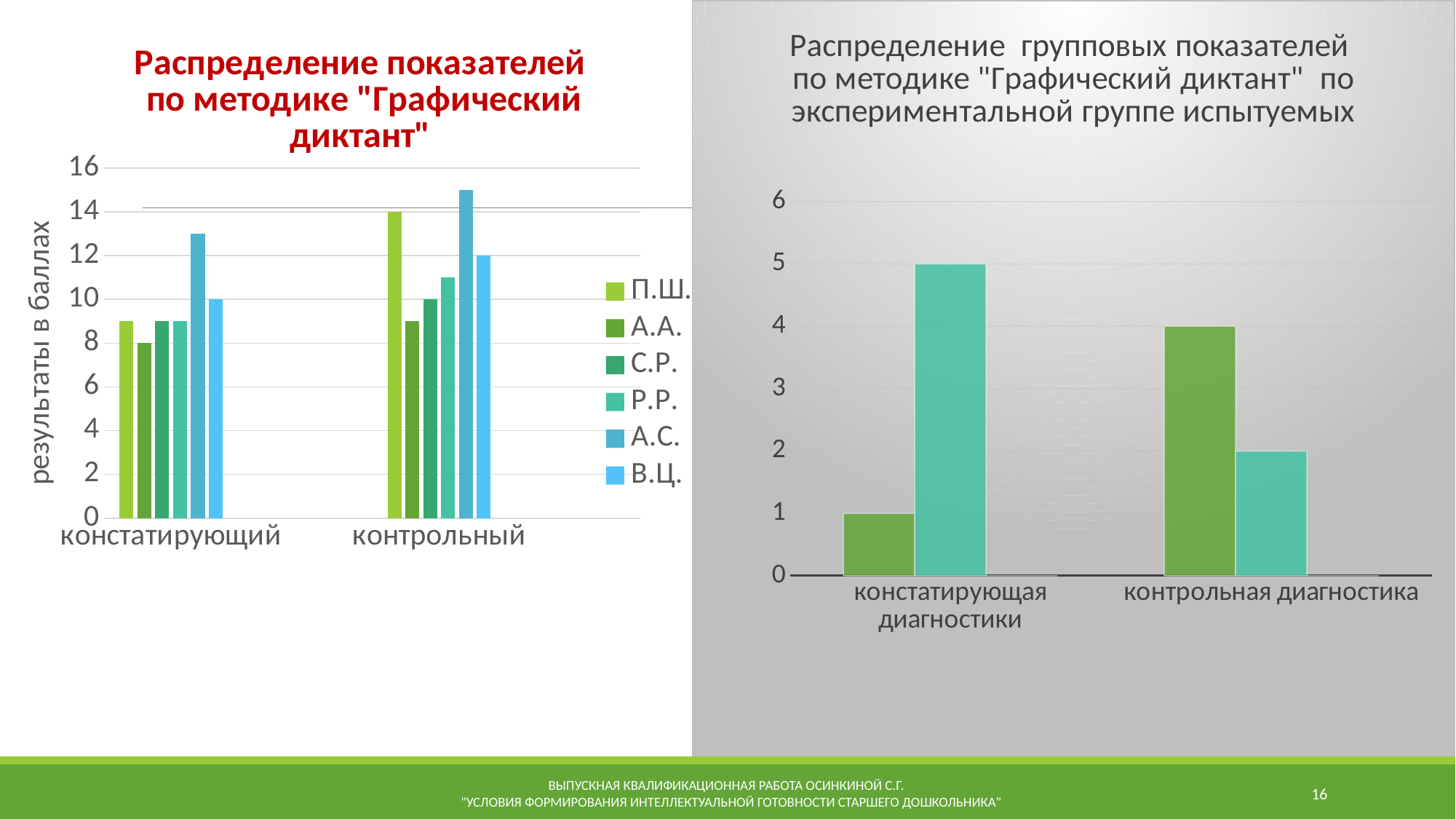
In the left chart "Распределение показателей по методике "Графический диктант"", what is the value for П.Ш. in the контрольный category? 14 In the left chart "Распределение показателей по методике "Графический диктант"", which is larger: А.С. in констатирующий or А.С. in контрольный? А.С. in контрольный In the left chart "Распределение показателей по методике "Графический диктант"", which series has the highest value in the контрольный category? А.С. In the left chart "Распределение показателей по методике "Графический диктант"", how many series does the legend list? 6 In the right chart "Распределение групповых показателей по методике "Графический диктант" по экспериментальной группе испытуемых", what is the difference between the teal bar for констатирующая диагностики and the teal bar for контрольная диагностика? 3 In the left chart "Распределение показателей по методике "Графический диктант"", what kind of chart is shown? bar chart In the left chart "Распределение показателей по методике "Графический диктант"", what is the value for В.Ц. in the контрольный category? 12 In the left chart "Распределение показателей по методике "Графический диктант"", what is the value for А.А. in the констатирующий category? 8 In the left chart "Распределение показателей по методике "Графический диктант"", is the value for А.С. in the констатирующий category greater or less than 12? greater In the right chart "Распределение групповых показателей по методике "Графический диктант" по экспериментальной группе испытуемых", what is the value of the teal bar for констатирующая диагностики? 5 In the left chart "Распределение показателей по методике "Графический диктант"", what is the y-axis title? результаты в баллах In the right chart "Распределение групповых показателей по методике "Графический диктант" по экспериментальной группе испытуемых", what is the value of the green bar for контрольная диагностика? 4